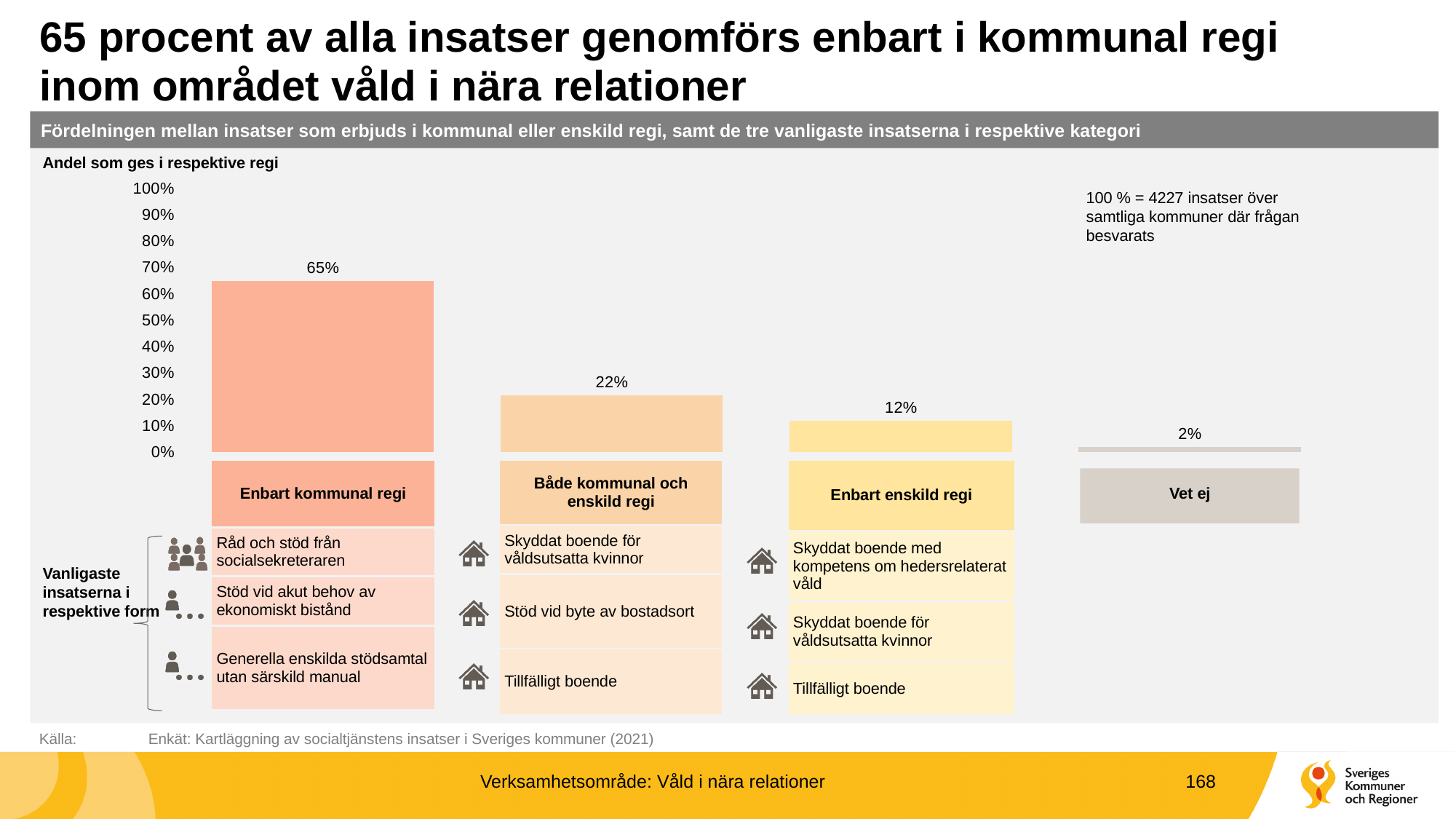
According to the note on the chart, how many insatser does 100% correspond to? 4227 What is the value for "Vet ej"? 2% Which category has the lowest value? Vet ej Which is larger, the value for "Enbart enskild regi" or the value for "Vet ej"? Enbart enskild regi How many categories are shown in the chart? 4 What is the value for "Både kommunal och enskild regi"? 22% What is the value for "Enbart enskild regi"? 12% What is the difference between the values for "Enbart kommunal regi" and "Både kommunal och enskild regi"? 43 percentage points Which category has the highest value? Enbart kommunal regi What is the value for "Enbart kommunal regi"? 65% Is the value for "Enbart kommunal regi" greater or less than 50%? greater What kind of chart is shown on the slide? Bar chart